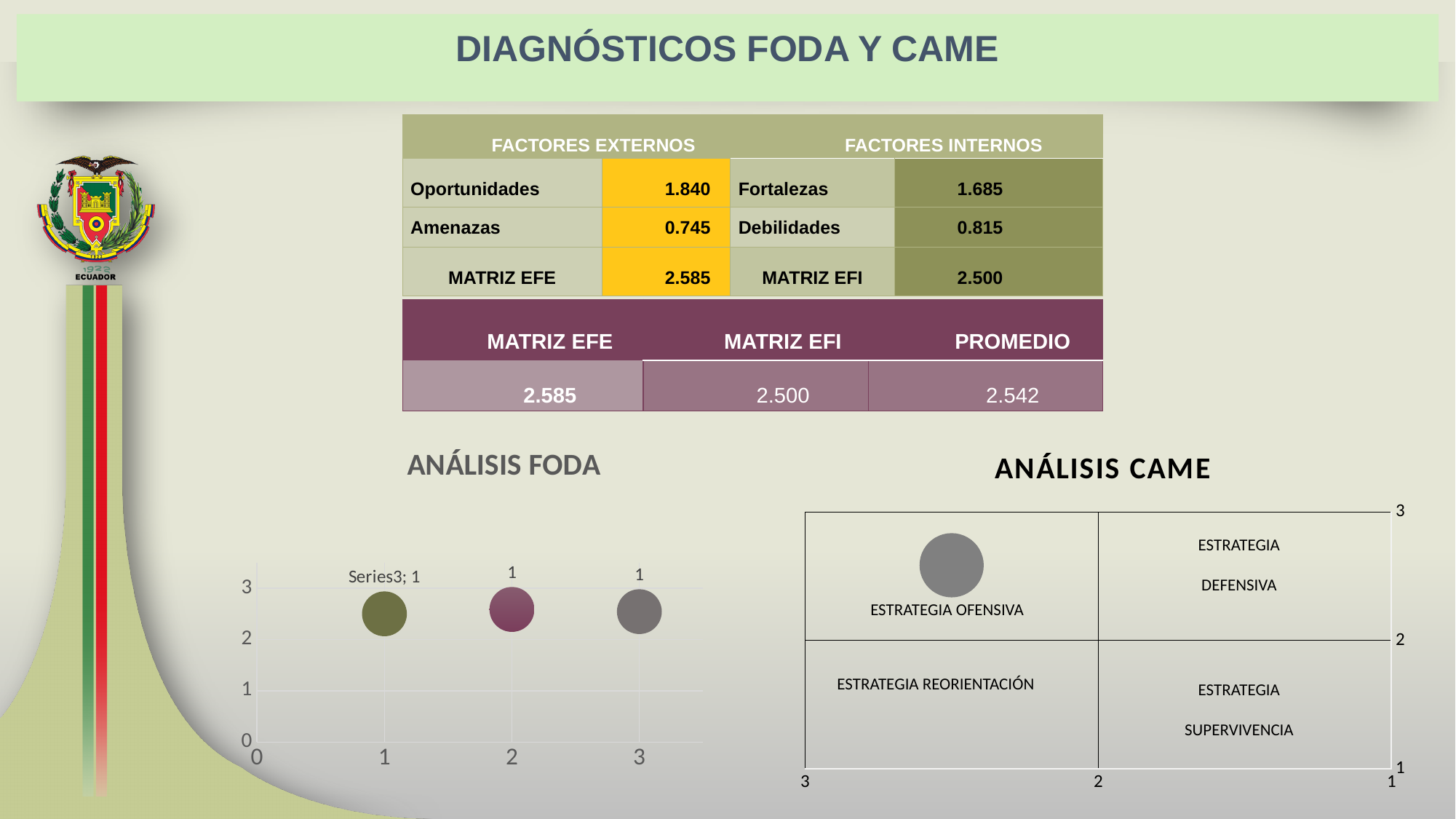
How many quadrants does the ANÁLISIS CAME chart have? 4 On the ANÁLISIS CAME chart, in which quadrant is the bubble located? ESTRATEGIA OFENSIVA On the ANÁLISIS FODA chart, what data label is shown above the bubble at x = 2? 1 On the ANÁLISIS CAME chart, what is the value at the top of the right-hand vertical axis? 3 On the ANÁLISIS FODA chart, what data label is shown above the bubble at x = 1? Series3; 1 What kind of chart is the ANÁLISIS FODA chart? bubble chart On the ANÁLISIS FODA chart, is the vertical position of the bubble at x = 3 greater or less than 3? less On the ANÁLISIS FODA chart, is the vertical position of the bubble at x = 1 greater or less than 2? greater What is the title of the chart on the left of the slide? ANÁLISIS FODA How many bubbles are plotted on the ANÁLISIS FODA chart? 3 How many tick labels are shown on the horizontal axis of the ANÁLISIS FODA chart? 4 On the ANÁLISIS FODA chart, what is the highest value shown on the vertical axis? 3